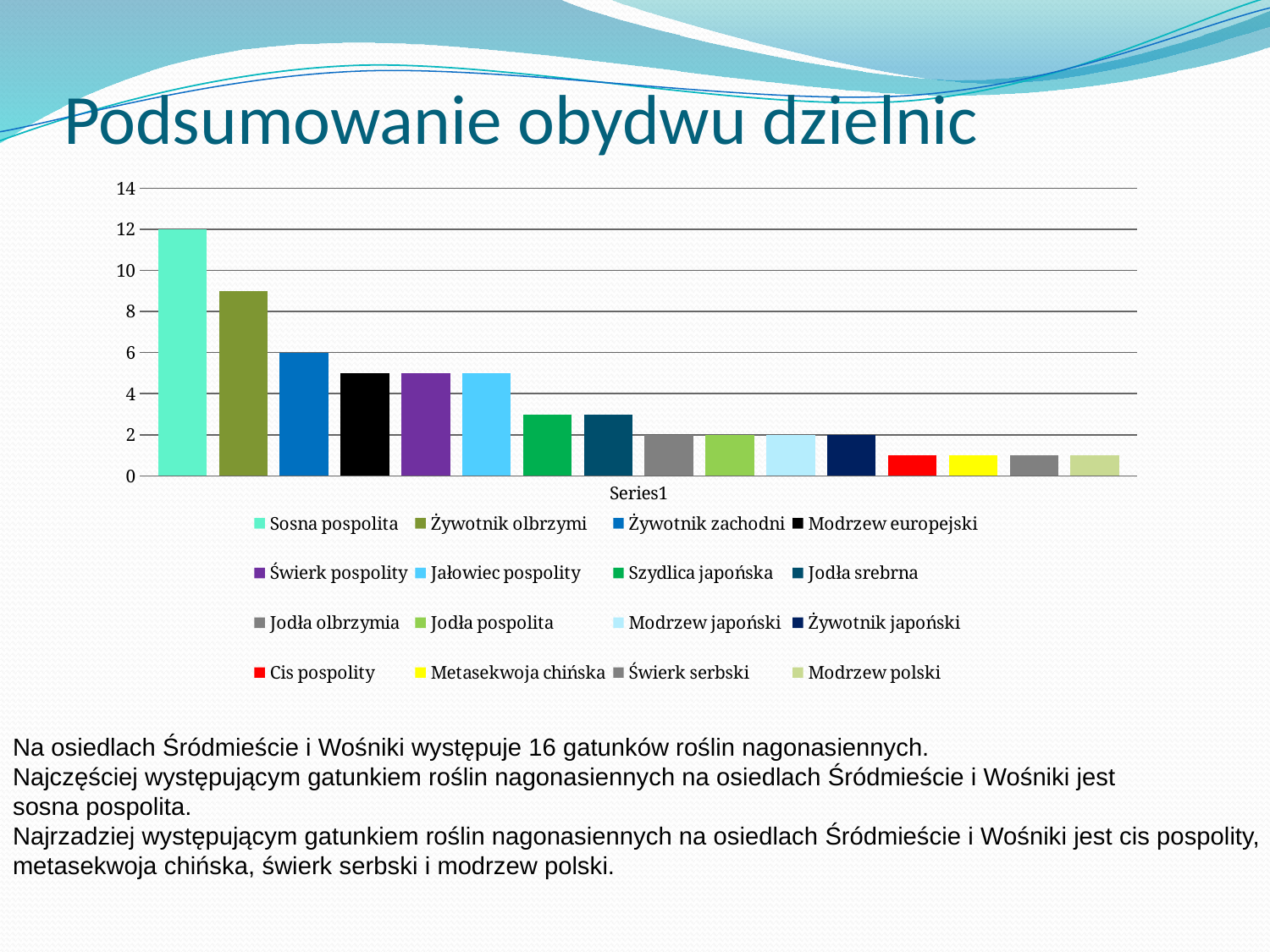
Is the value for Żywotnik olbrzymi greater or less than 8? greater Which series has the highest value in the chart? Sosna pospolita What colour is the bar for Cis pospolity? red What type of chart is shown on the slide? bar chart What is the value for Jodła olbrzymia? 2 Is the value for Cis pospolity greater or less than 2? less What is the value for Żywotnik zachodni? 6 Which is larger, the value for Sosna pospolita or the value for Żywotnik olbrzymi? Sosna pospolita How many series does the chart legend list? 16 Is the value for Modrzew europejski greater or less than 4? greater What is the value for Sosna pospolita? 12 What is the difference between the values for Sosna pospolita and Żywotnik zachodni? 6